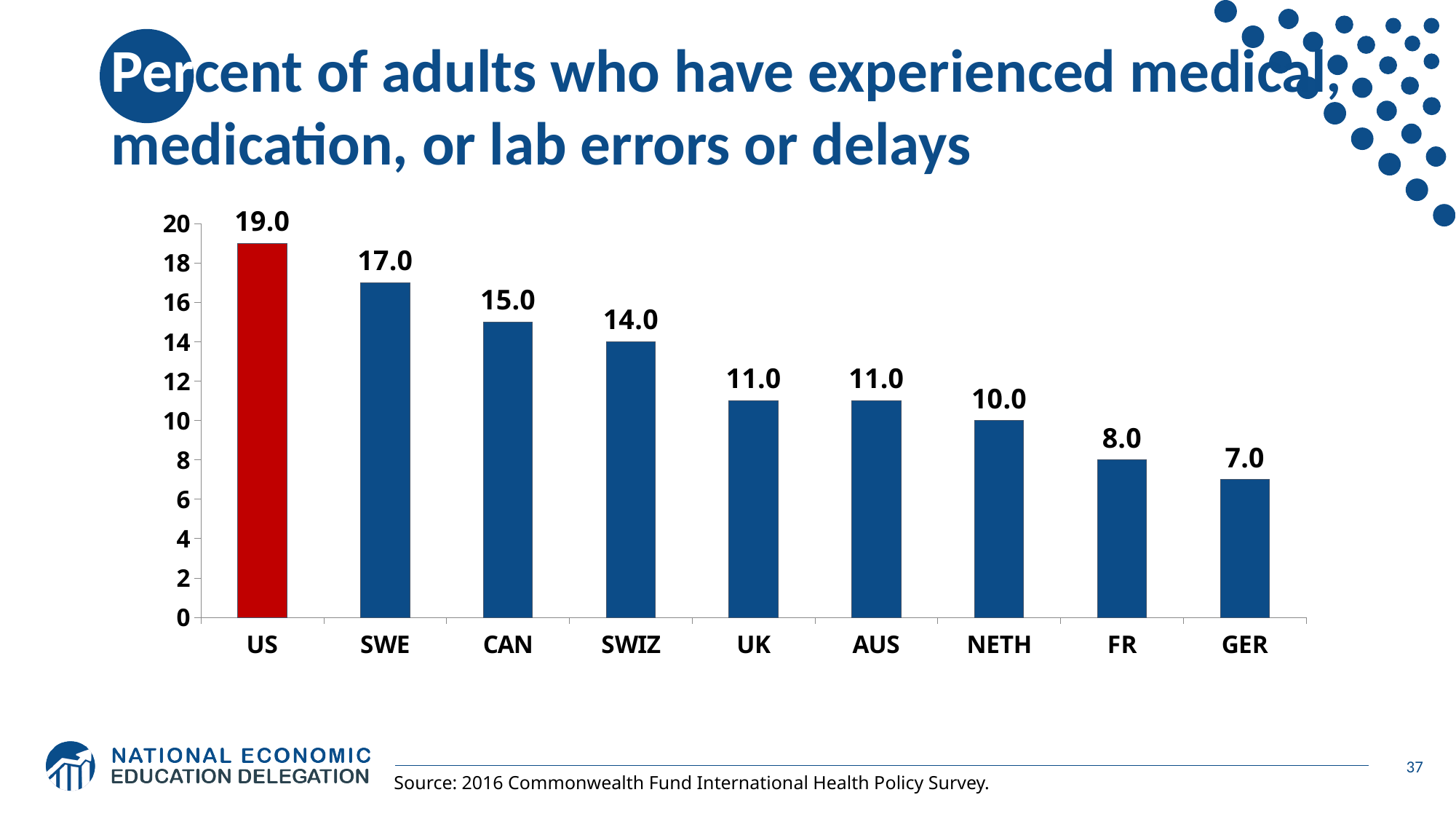
What is the difference between the values for the US and SWE? 2.0 Which bar is coloured red rather than blue? US Do the values rise or fall from left to right along the x axis? fall What is the difference between the values for CAN and GER? 8.0 What is the value for NETH? 10.0 How many countries are shown on the chart? 9 Which country has the lowest value? GER Which is larger, the value for FR or the value for NETH? NETH What is the value for the US? 19.0 What is the value for SWIZ? 14.0 Which country has the highest value? US What kind of chart is shown on the slide? bar chart